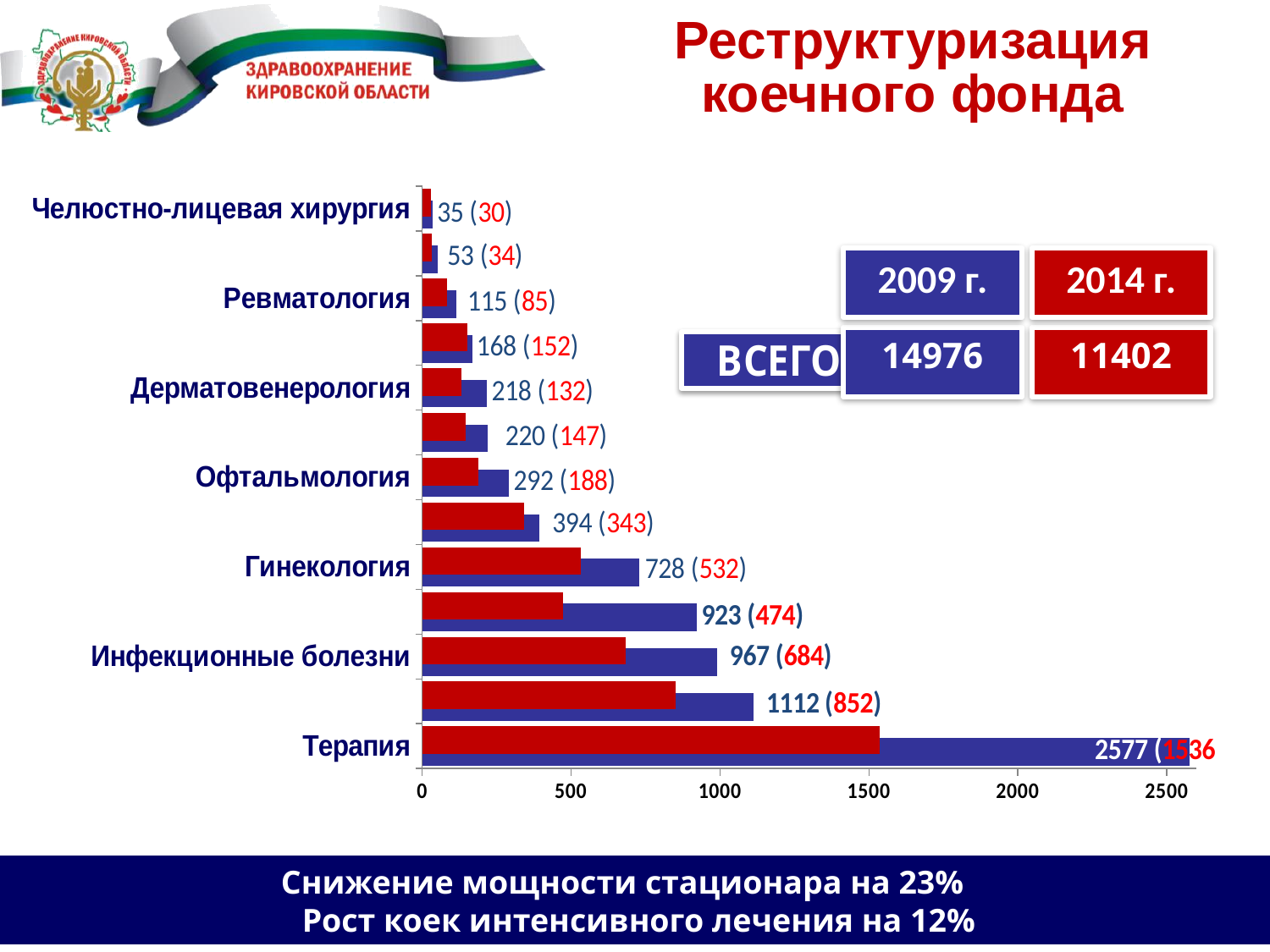
What was the number of beds for Терапия in 2009? 2577 What type of chart is shown on the slide? Bar chart By how much did the number of beds for Дерматовенерология decrease from 2009 to 2014? 86 Is the 2009 value for Терапия greater or less than 2500? greater What was the number of beds for Гинекология in 2014? 532 Which category has the highest number of beds in 2009? Терапия Which is larger: the 2009 value for Ревматология or the 2009 value for Дерматовенерология? Дерматовенерология Which labelled category has the lowest number of beds in 2014? Челюстно-лицевая хирургия How many categories (bar pairs) are plotted in the chart? 13 What was the number of beds for Офтальмология in 2014? 188 What was the number of beds for Инфекционные болезни in 2009? 967